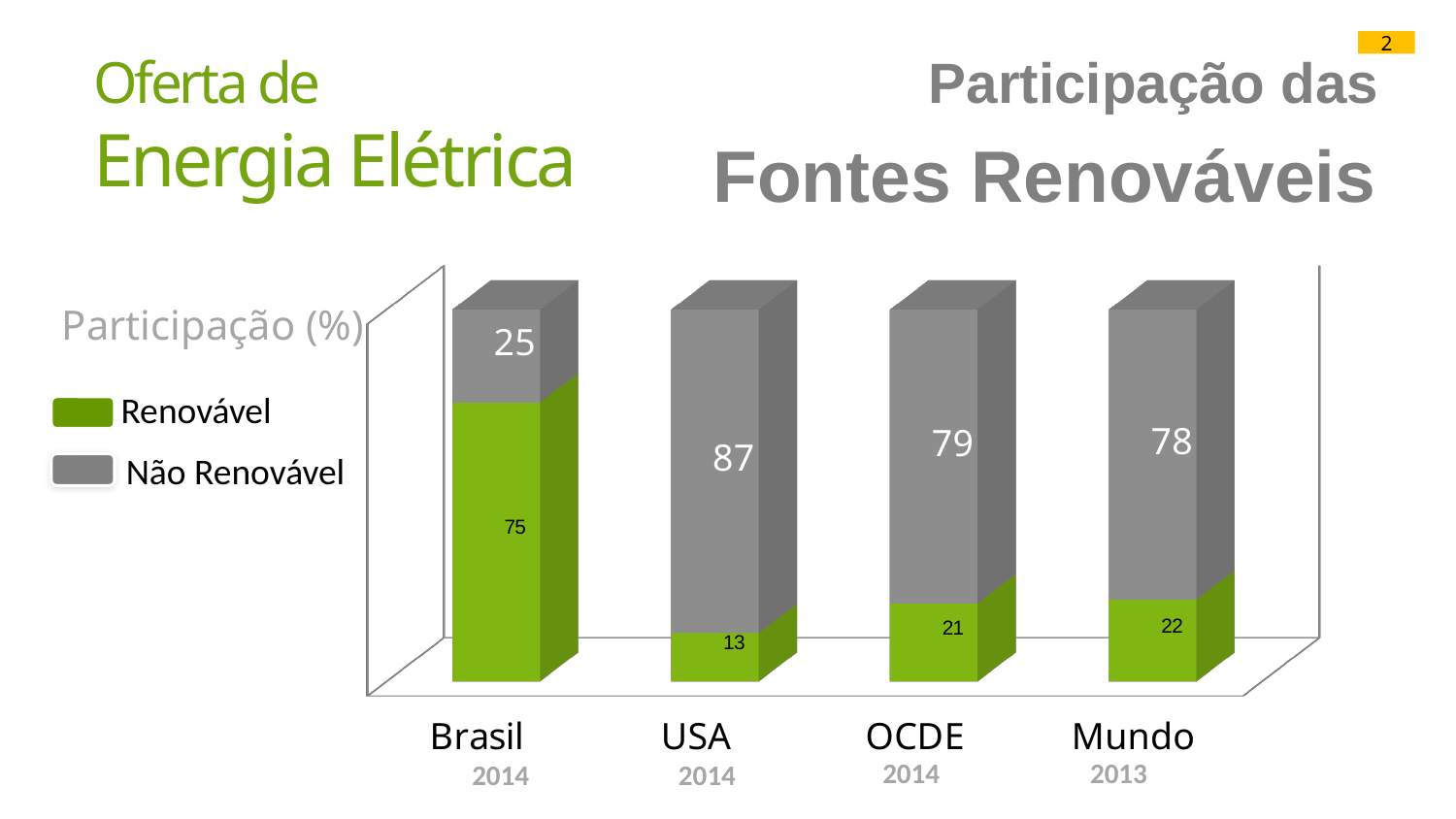
What is the Não Renovável value for Mundo? 78 What is the difference between the Renovável values for Brasil and USA? 62 What is the Renovável value for OCDE? 21 What is the total of the stacked bar for Brasil? 100 What kind of chart is shown on the slide? Stacked bar chart Which category has the highest Renovável value? Brasil How many series does the legend list? 2 What is the Não Renovável value for USA? 87 What is the Renovável value for Brasil? 75 How many categories are shown on the x axis? 4 Which is larger, the Renovável value for OCDE or for Mundo? Mundo Which category has the lowest Renovável value? USA